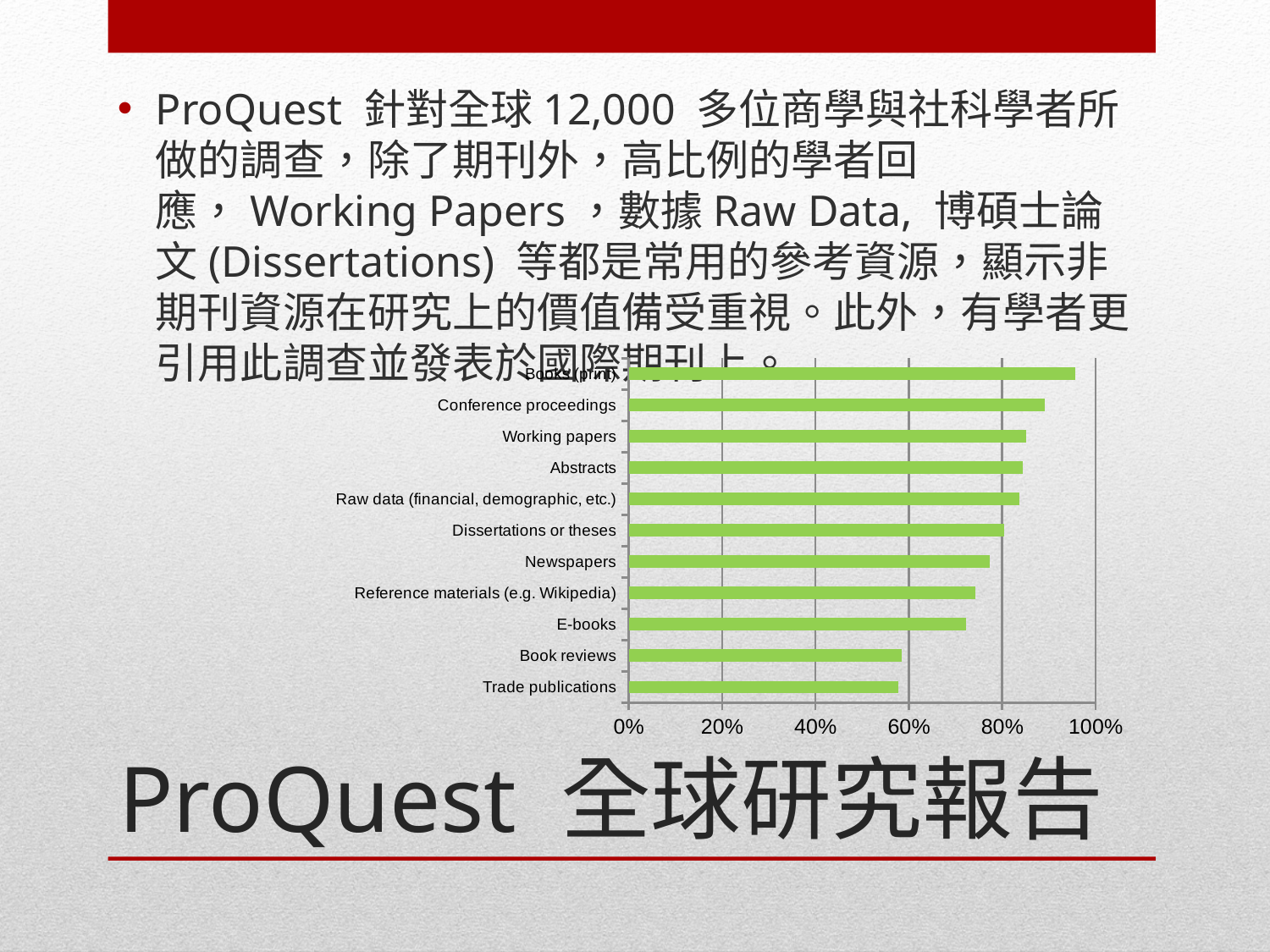
What kind of chart is shown on the slide? bar chart Is the value for Working papers greater or less than 80%? greater How many categories are plotted in the chart? 11 Is the value for E-books greater or less than 60%? greater Is the value for Trade publications greater or less than 60%? less Which has the larger value, Conference proceedings or Newspapers? Conference proceedings Which has the larger value, Working papers or E-books? Working papers What colour are the bars in the chart? green